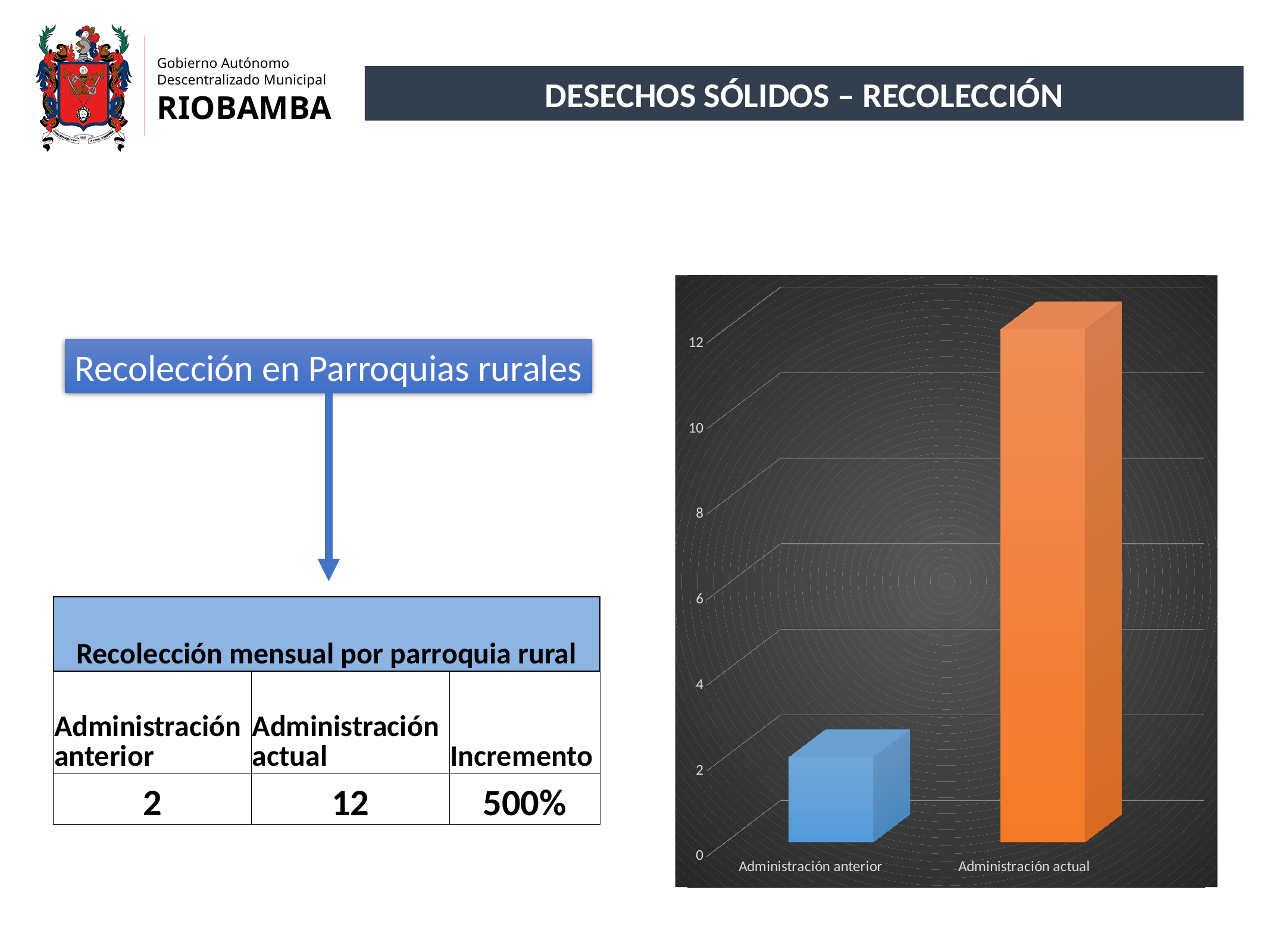
Which is larger, the value for Administración anterior or the value for Administración actual? Administración actual Which category has the highest value in the chart? Administración actual What is the value for Administración actual in the chart? 12 What is the difference between the values for Administración actual and Administración anterior? 10 Is the value for Administración anterior greater or less than 4? less What colour is the bar for Administración actual? orange Which category has the lowest value in the chart? Administración anterior What is the value for Administración anterior in the chart? 2 Do the values rise or fall from Administración anterior to Administración actual along the x axis? rise Is the value for Administración actual greater or less than 10? greater How many bars does the chart show? 2 What kind of chart is shown on the slide? bar chart